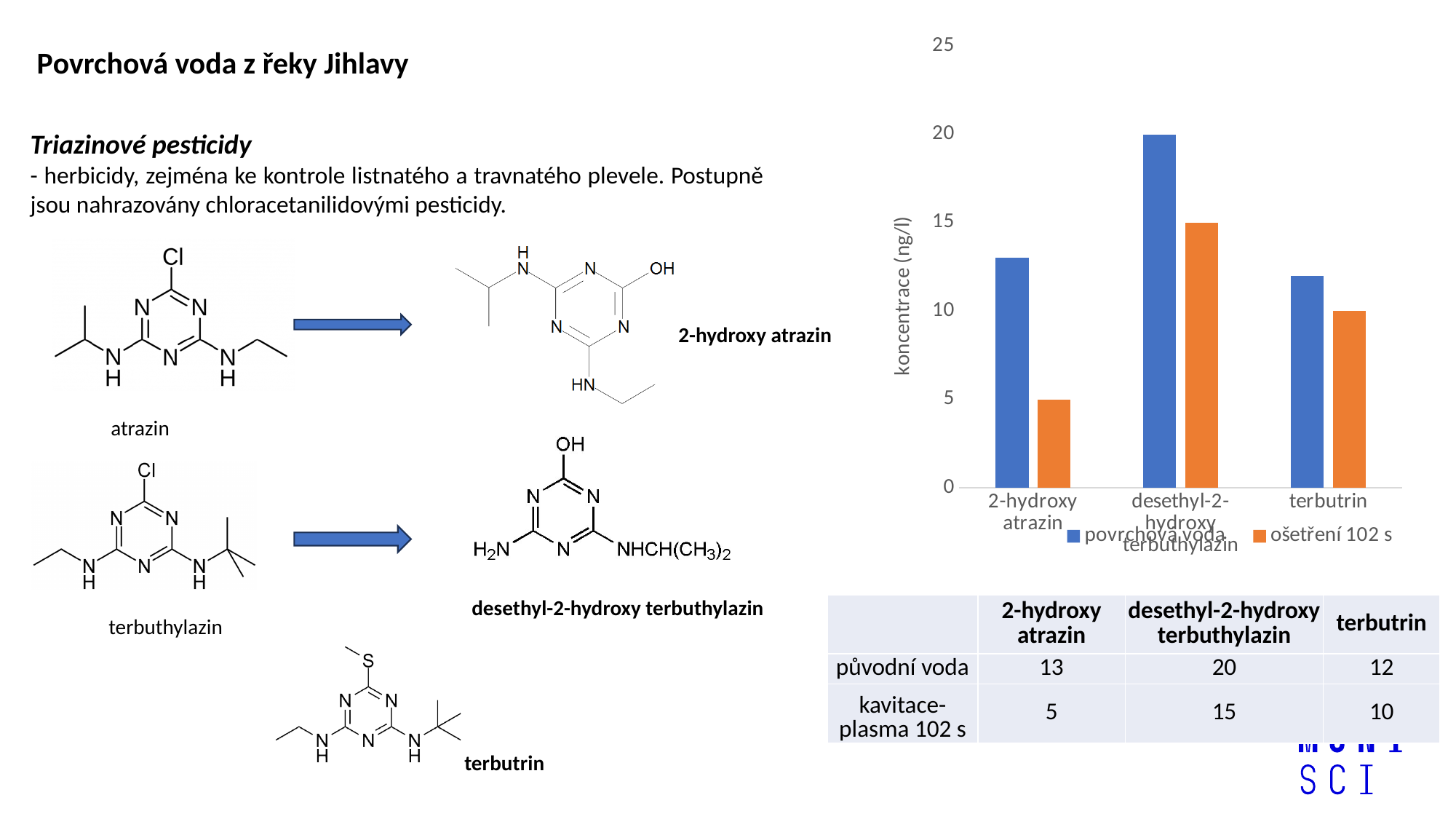
What is the concentration of desethyl-2-hydroxy terbuthylazin after ošetření 102 s? 15 How many categories are shown on the x axis of the chart? 3 What is the concentration of terbutrin after ošetření 102 s? 10 What is the concentration of desethyl-2-hydroxy terbuthylazin in povrchová voda? 20 What is the label of the y axis of the chart? koncentrace (ng/l) Is the povrchová voda value for 2-hydroxy atrazin greater or less than 10? greater Which category has the highest concentration in povrchová voda? desethyl-2-hydroxy terbuthylazin What is the concentration of 2-hydroxy atrazin after ošetření 102 s? 5 Which is larger for terbutrin: the povrchová voda value or the ošetření 102 s value? povrchová voda What kind of chart is shown on the slide? bar chart How many series does the chart legend list? 2 Which category has the lowest concentration after ošetření 102 s? 2-hydroxy atrazin